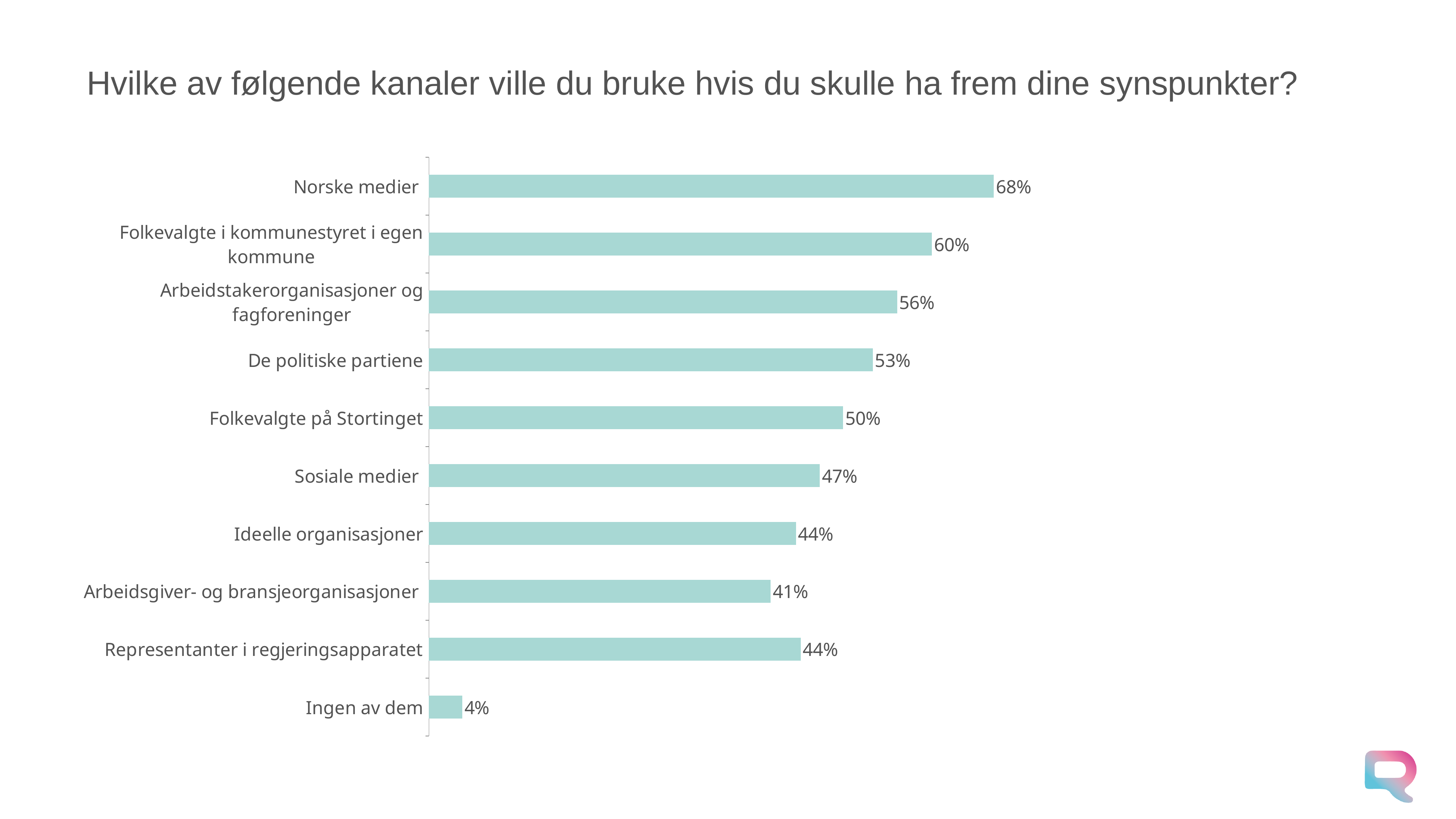
Which category has the lowest value? Ingen av dem What is the value for Arbeidsgiver- og bransjeorganisasjoner? 41% Which category has the highest value? Norske medier What is the value for Norske medier? 68% What is the difference between the values for Norske medier and Folkevalgte i kommunestyret i egen kommune? 8% What is the value for Sosiale medier? 47% How many categories are shown in the chart? 10 What kind of chart is shown on the slide? Bar chart What is the difference between the values for De politiske partiene and Sosiale medier? 6% What is the title of the chart? Hvilke av følgende kanaler ville du bruke hvis du skulle ha frem dine synspunkter? What is the value for Folkevalgte på Stortinget? 50% Which is larger, the value for Arbeidstakerorganisasjoner og fagforeninger or the value for De politiske partiene? Arbeidstakerorganisasjoner og fagforeninger